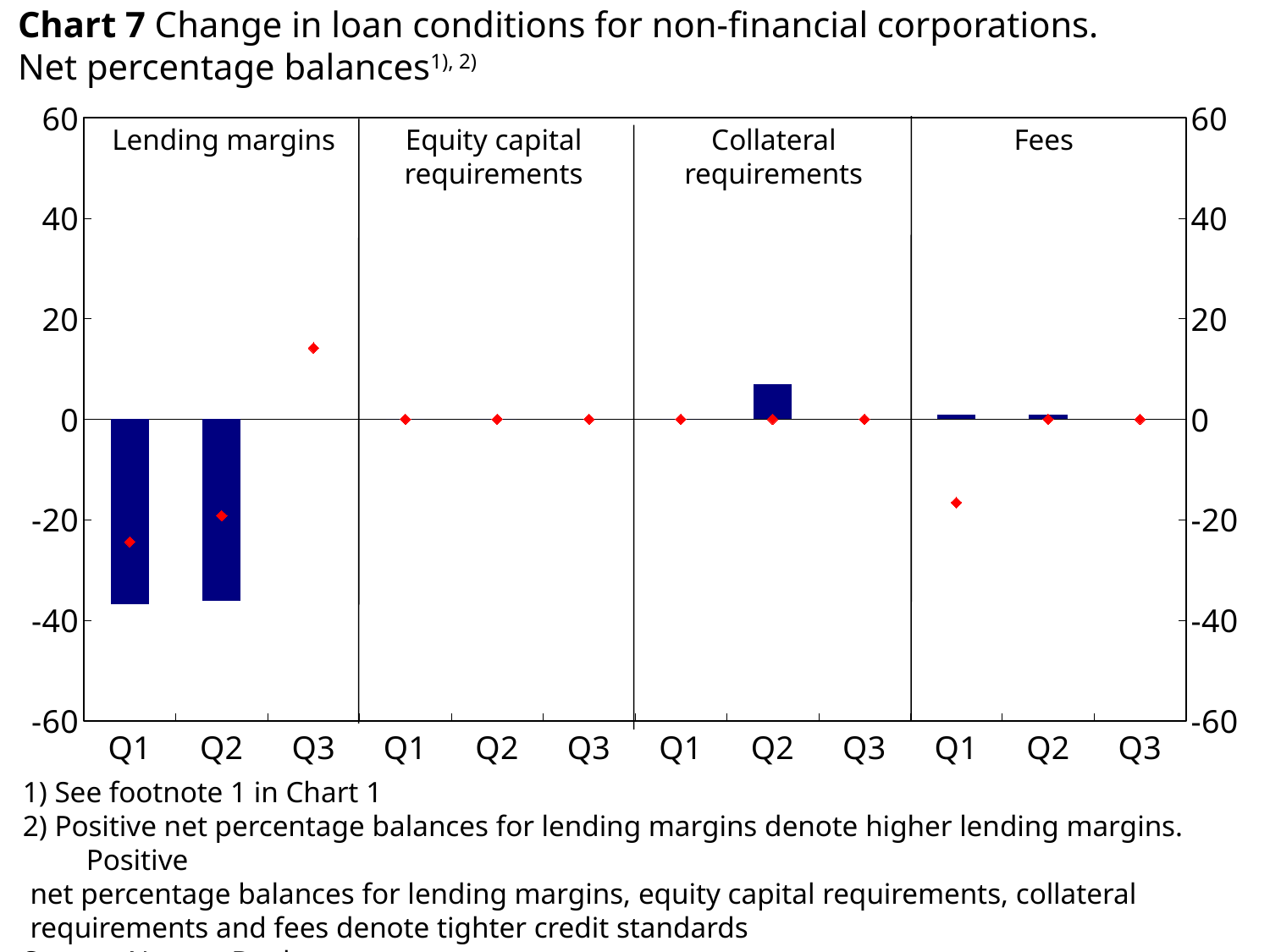
Which is larger: the Q2 bar in the Collateral requirements panel or the Q1 bar in the Lending margins panel? Collateral requirements Q2 In the Lending margins panel, is the Q3 red marker greater or less than 20? less In the Collateral requirements panel, is the Q2 bar greater or less than 20? less How many quarters are plotted within each panel of Chart 7? 3 What kind of chart is Chart 7? combination bar and line (marker) chart How many loan condition panels are shown in Chart 7? 4 In the Fees panel, is the Q1 red marker greater or less than -20? greater Which panel contains the highest positive bar in Chart 7? Collateral requirements Which panel contains the lowest (most negative) bars in Chart 7? Lending margins What are the minimum and maximum values shown on the vertical axis of Chart 7? -60 and 60